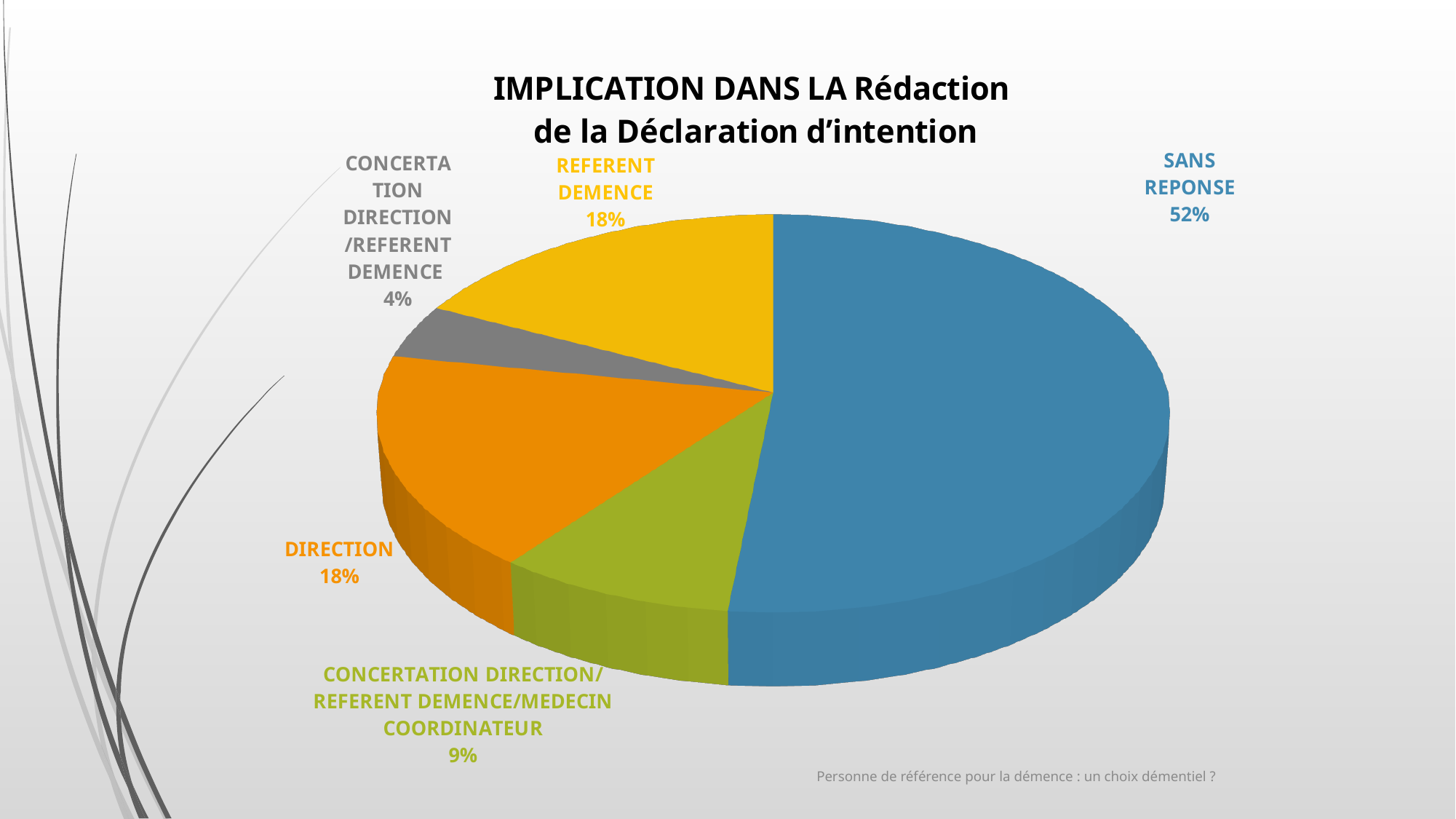
What is the difference in percentage points between SANS REPONSE and DIRECTION? 34 What colour is the SANS REPONSE slice? blue Which is larger, the share for DIRECTION or the share for CONCERTATION DIRECTION/REFERENT DEMENCE/MEDECIN COORDINATEUR? DIRECTION What kind of chart is shown on the slide? pie chart What percentage is shown for REFERENT DEMENCE? 18% Which category has the smallest slice of the pie? CONCERTATION DIRECTION/REFERENT DEMENCE Which category has the largest slice of the pie? SANS REPONSE What percentage is shown for CONCERTATION DIRECTION/REFERENT DEMENCE/MEDECIN COORDINATEUR? 9% What percentage is shown for CONCERTATION DIRECTION/REFERENT DEMENCE? 4% How many slices does the pie chart have? 5 What share of the pie is labelled SANS REPONSE? 52% What percentage is shown for DIRECTION? 18%